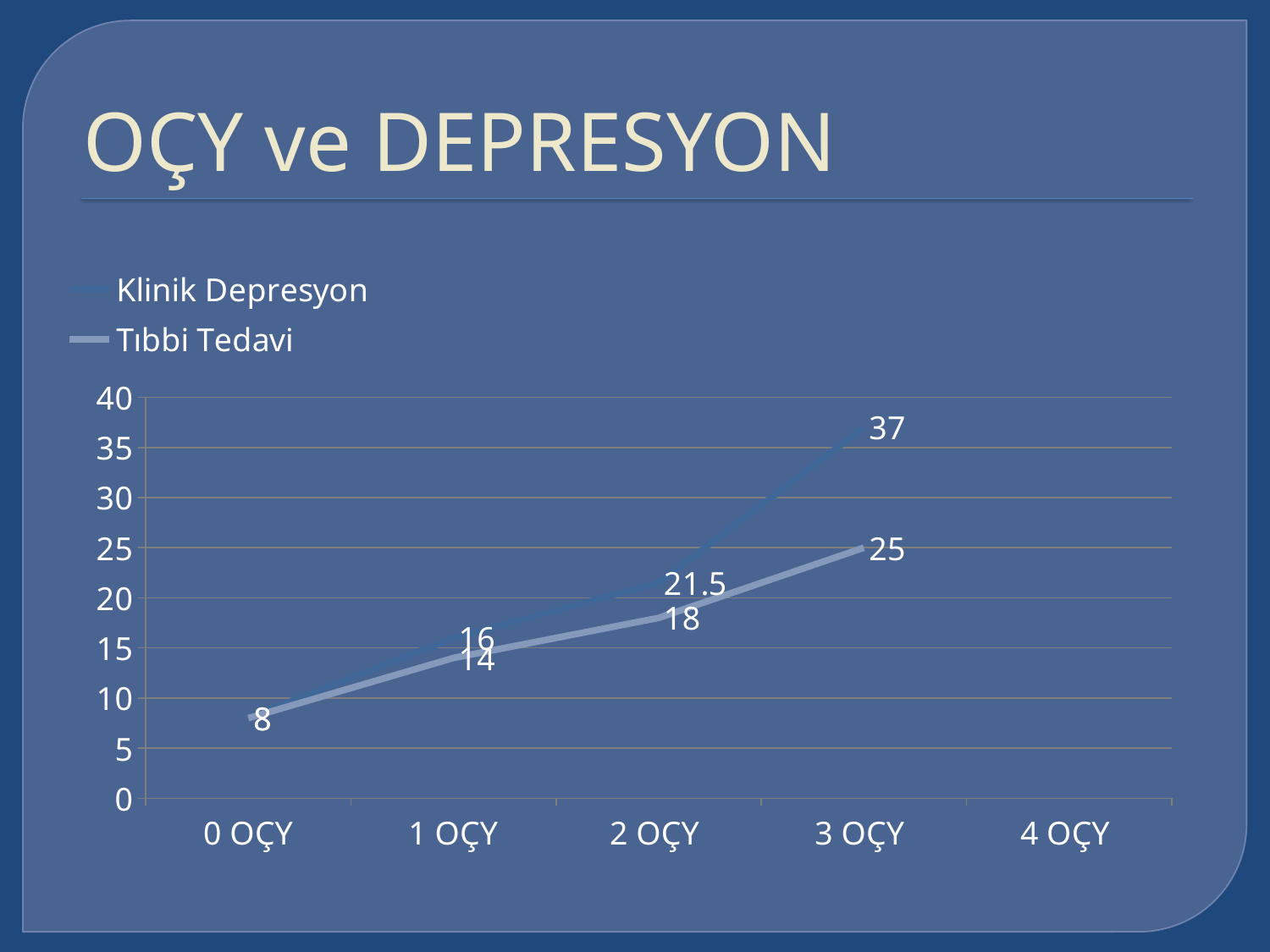
Which series has the larger value at 2 OÇY, Klinik Depresyon or Tıbbi Tedavi? Klinik Depresyon At which category does Klinik Depresyon reach its highest value? 3 OÇY What type of chart is shown on the slide? line chart What value is labelled at 0 OÇY? 8 What is the value of Klinik Depresyon at 3 OÇY? 37 What is the difference between Klinik Depresyon and Tıbbi Tedavi at 3 OÇY? 12 How many series does the legend list? 2 What is the value of Tıbbi Tedavi at 1 OÇY? 14 How many categories are shown on the x axis? 5 What is the value of Tıbbi Tedavi at 3 OÇY? 25 What is the value of Klinik Depresyon at 2 OÇY? 21.5 Do the values of Tıbbi Tedavi rise or fall from 0 OÇY to 3 OÇY? rise